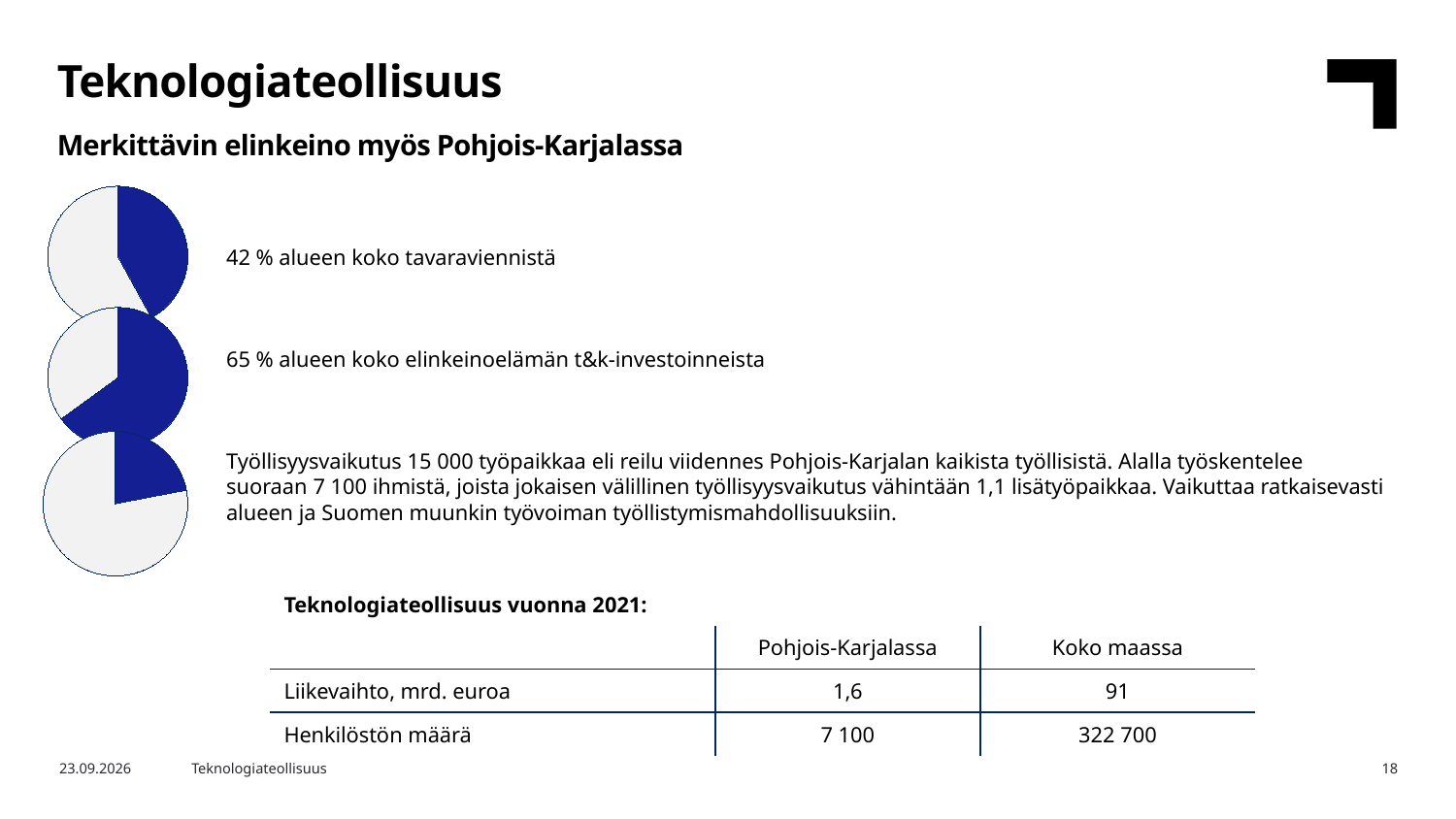
In the bottom pie chart, is the blue slice larger or smaller than half of the pie? smaller In the top pie chart, what share of the region's total goods exports (tavaravienti) does the blue slice represent? 42 % What colour is the highlighted slice in each of the pie charts? blue Which pie chart has the larger blue slice, the top one or the middle one? the middle one What kind of chart is the top chart on the left side of the slide? pie chart Which of the three pie charts has the largest blue slice? the middle one In the middle pie chart, what share of the region's business R&D investments (t&k-investoinnit) does the blue slice represent? 65 % Which of the three pie charts has the smallest blue slice? the bottom one In the middle pie chart, is the blue slice larger or smaller than half of the pie? larger How many pie charts are shown on the slide? 3 How many slices does each pie chart have? 2